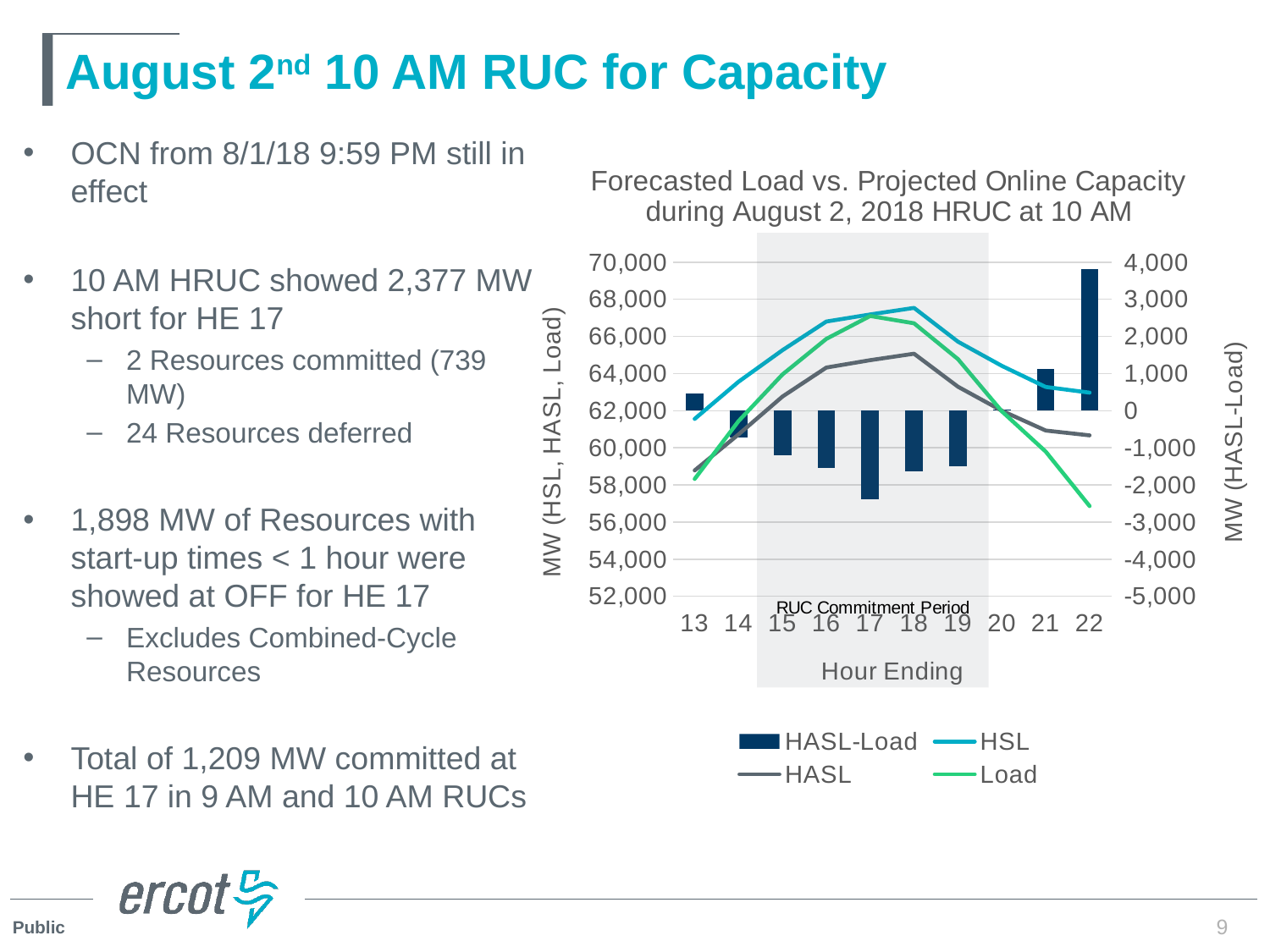
At which Hour Ending is the HASL-Load bar highest? 22 How many Hour Ending categories are shown on the x axis of the chart? 10 At which Hour Ending is the HASL-Load bar lowest? 17 Which is higher at Hour Ending 22, HSL or Load? HSL Does the Load line rise or fall from Hour Ending 18 to Hour Ending 22? fall What is the title of the chart? Forecasted Load vs. Projected Online Capacity during August 2, 2018 HRUC at 10 AM Is the HASL-Load value for Hour Ending 22 greater or less than 3,000? greater What kind of chart is shown on the slide? Combination bar and line chart Which series in the chart is plotted as bars? HASL-Load Is the HASL-Load value for Hour Ending 17 greater or less than -2,000? less Is the Load value for Hour Ending 22 greater or less than 58,000? less How many series does the chart legend list? 4